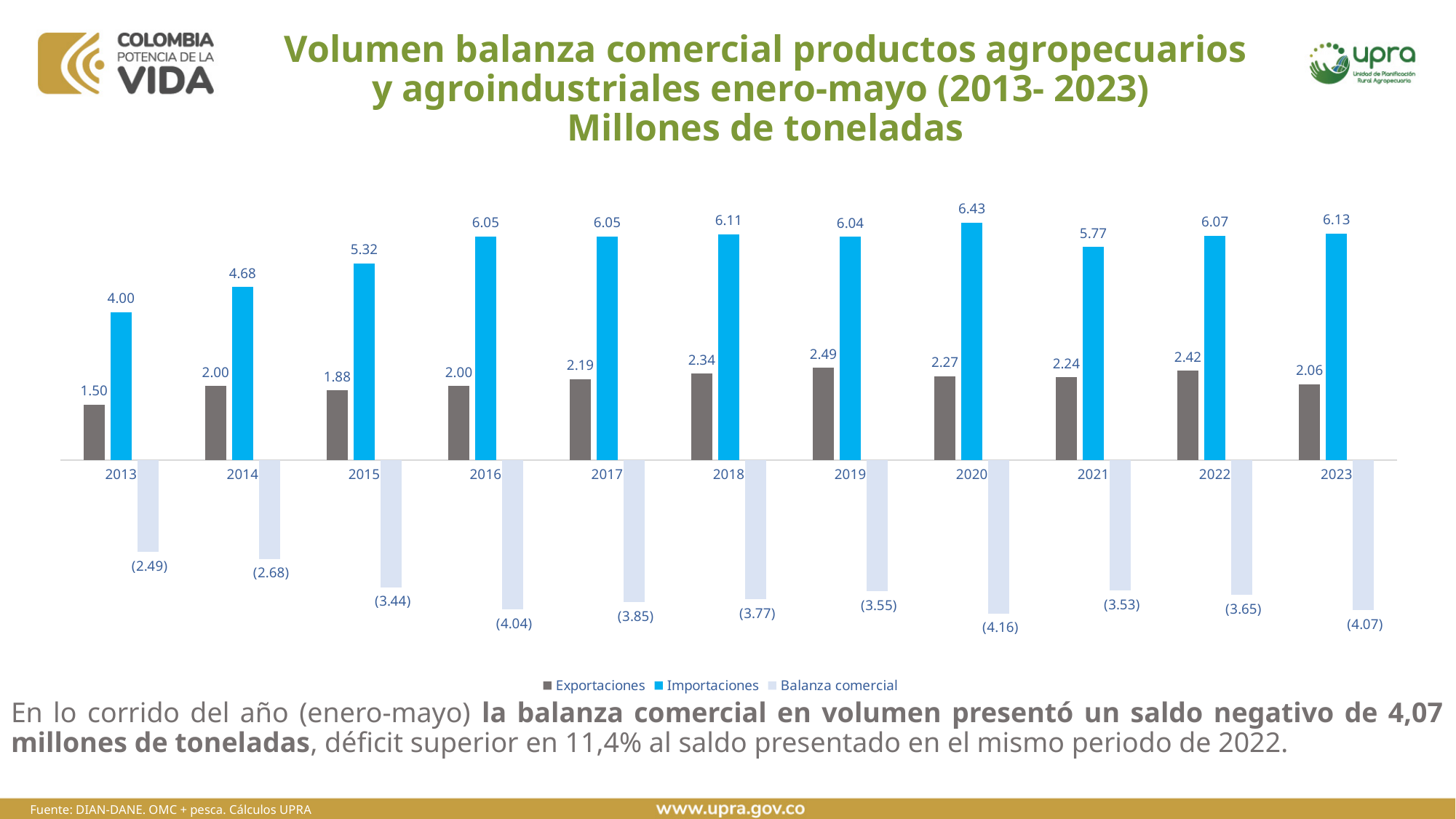
What is the difference between Importaciones and Exportaciones in 2023? 4.07 How many series does the legend list? 3 What is the difference between Importaciones in 2020 and in 2021? 0.66 How many years are shown on the x axis? 11 Which is larger, Exportaciones in 2018 or Exportaciones in 2022? 2022 In which year are Importaciones highest? 2020 What is the value of Exportaciones for 2013? 1.50 In which year are Importaciones lowest? 2013 What is the Balanza comercial value shown for 2023? (4.07) What is the value of Importaciones for 2020? 6.43 In which year are Exportaciones highest? 2019 What kind of chart is shown on the slide? Bar chart